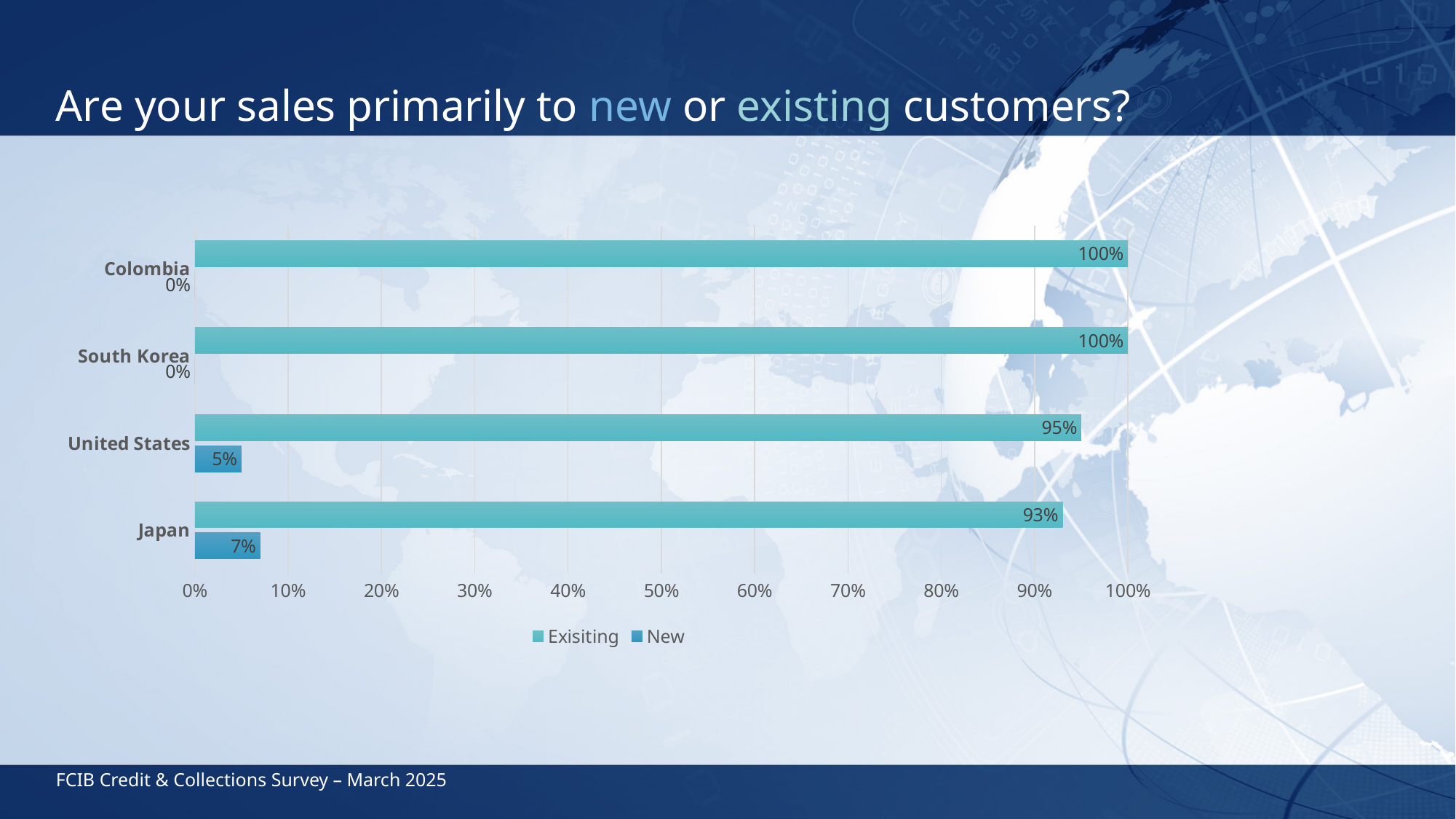
What is the Exisiting value for the United States? 95% What are the two series named in the legend? Exisiting and New Which is larger, the New value for Japan or the New value for the United States? Japan What is the Exisiting value for Japan? 93% Which country has the highest New value? Japan What is the New value for Colombia? 0% Which country has the lowest Exisiting value? Japan How many series does the legend list? 2 What kind of chart is shown on the slide? Bar chart How many countries are shown on the chart? 4 What is the New value for the United States? 5% What is the difference between the Exisiting values for Colombia and Japan? 7%